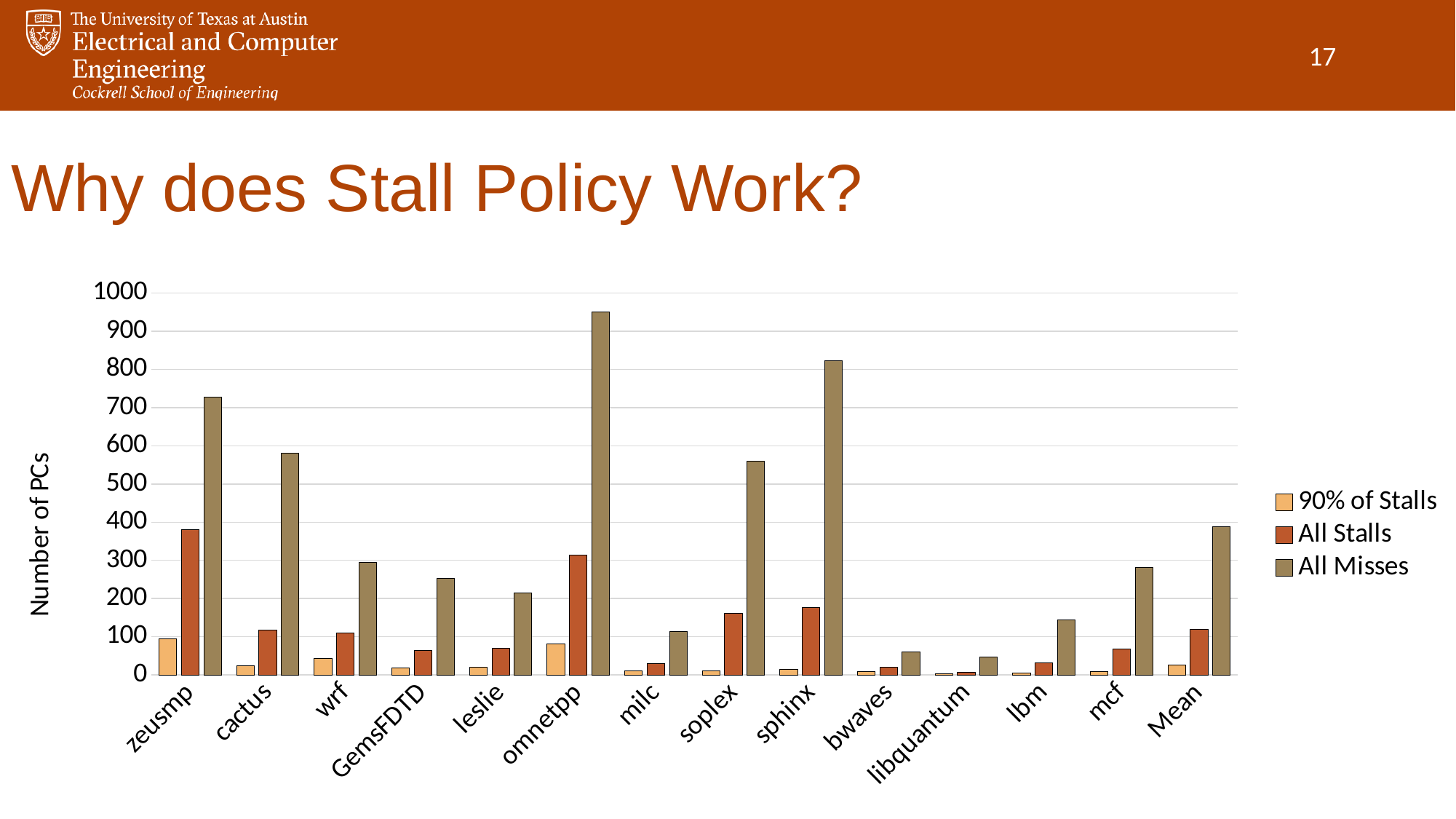
What kind of chart is shown on the slide? bar chart How many benchmark categories are shown along the x axis? 14 Which is larger, the All Stalls value for zeusmp or the All Stalls value for omnetpp? zeusmp Is the All Misses value for soplex greater or less than 500? greater Which category has the highest All Misses value? omnetpp What is the label of the y axis? Number of PCs Which category has the lowest All Misses value? libquantum Is the All Misses value for sphinx greater or less than 800? greater Is the All Stalls value for zeusmp greater or less than 400? less How many series does the legend list? 3 Which category has the highest All Stalls value? zeusmp